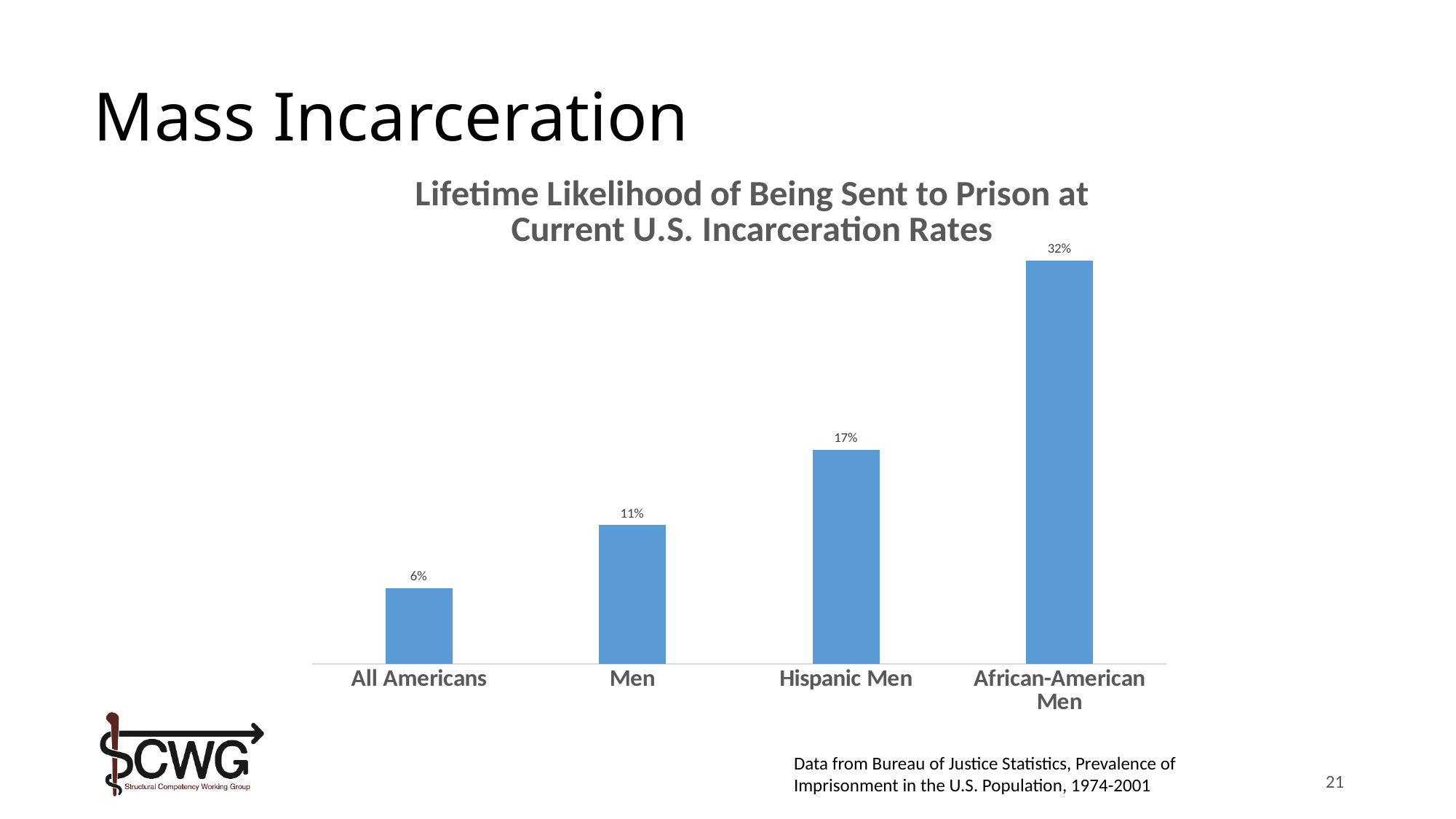
Which category has the highest lifetime likelihood of being sent to prison? African-American Men Which is larger, the value for Hispanic Men or the value for Men? Hispanic Men What is the difference in percentage points between African-American Men and Hispanic Men? 15 What kind of chart is shown on the slide? Bar chart What is the title of the chart? Lifetime Likelihood of Being Sent to Prison at Current U.S. Incarceration Rates Which category has the lowest lifetime likelihood of being sent to prison? All Americans What is the value shown for African-American Men? 32% What is the value shown for Men? 11% What is the difference in percentage points between Men and All Americans? 5 How many categories are shown in the chart? 4 What is the lifetime likelihood of being sent to prison for All Americans? 6% What is the value shown for Hispanic Men? 17%